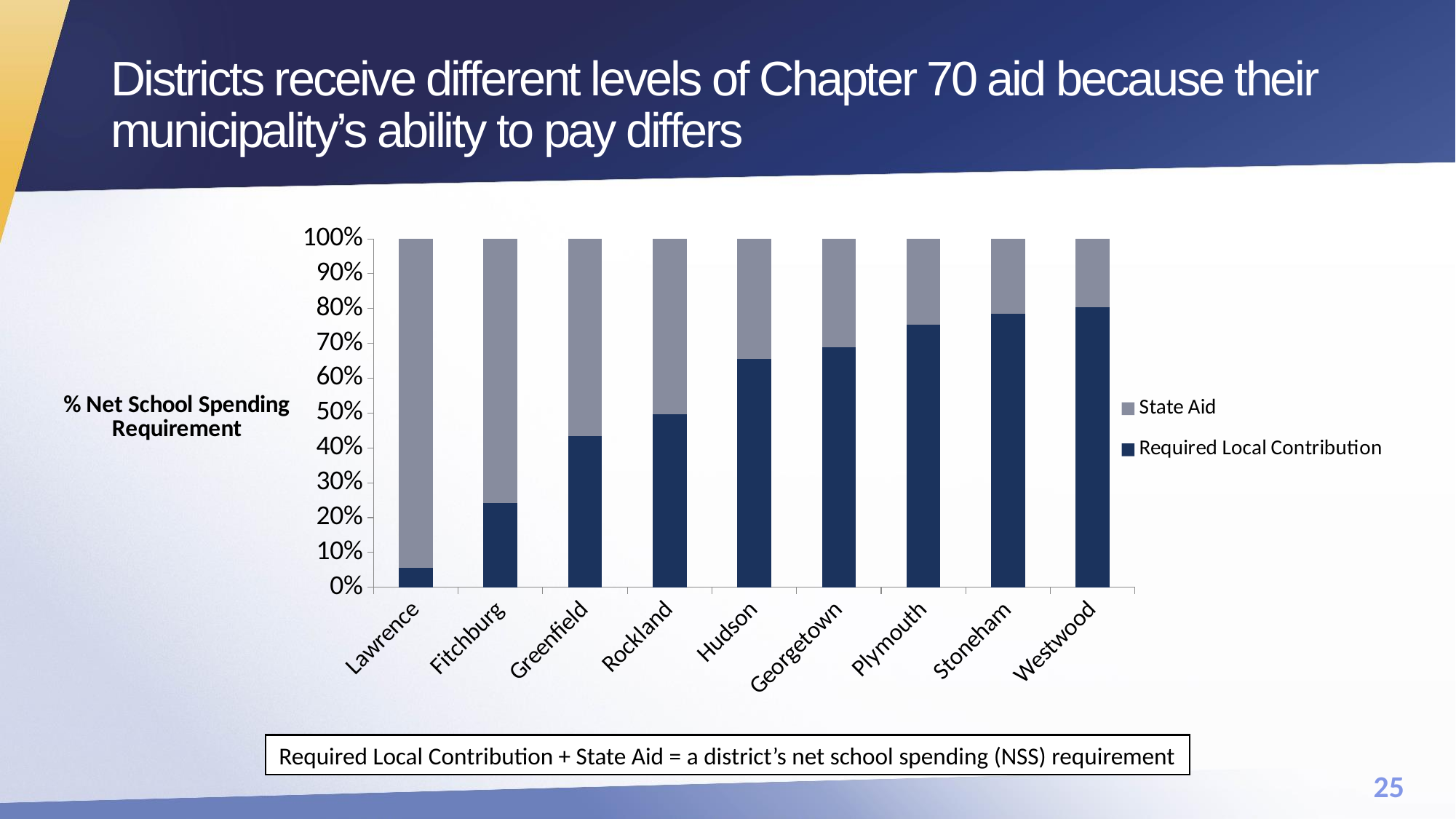
Is the Required Local Contribution for Lawrence greater or less than 10%? less What kind of chart is shown on the slide? Stacked bar chart Does the Required Local Contribution share rise or fall moving from Lawrence to Westwood along the x axis? Rise How many series does the chart's legend list? 2 Which district has the lowest Required Local Contribution share? Lawrence Is the Required Local Contribution for Greenfield greater or less than 40%? greater Which district has a larger Required Local Contribution share, Fitchburg or Hudson? Hudson How many districts are shown along the x axis of the chart? 9 Which district has the highest Required Local Contribution share? Westwood What is the label on the vertical axis of the chart? % Net School Spending Requirement Is the Required Local Contribution for Stoneham greater or less than 80%? less Which district has the largest State Aid share? Lawrence